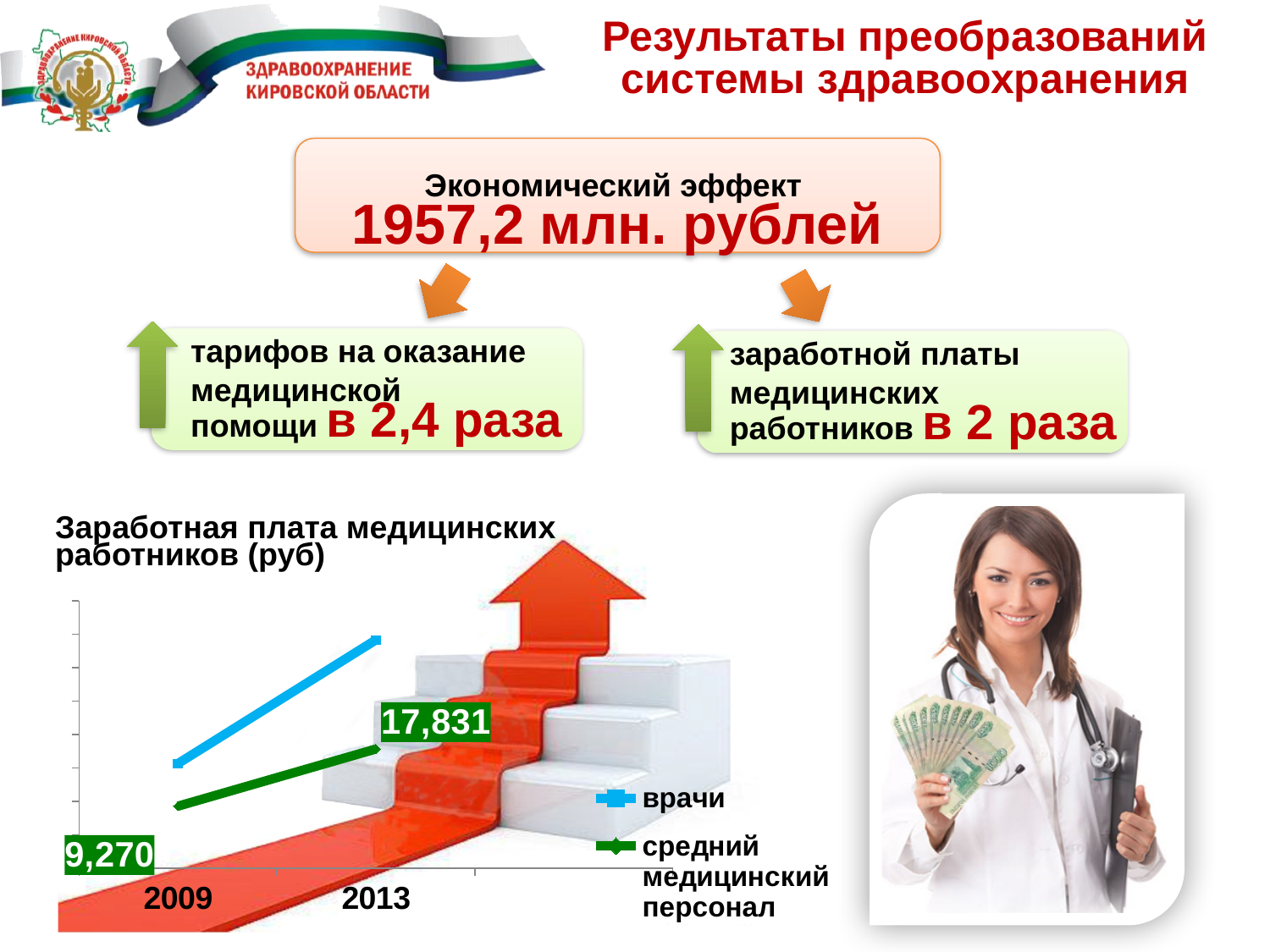
In 2009, which series has the higher value: врачи or средний медицинский персонал? врачи What is the value for средний медицинский персонал in 2013? 17,831 Which series has the lowest value on the chart? средний медицинский персонал Do the salary values rise or fall from 2009 to 2013? rise Which series has the highest value on the chart? врачи How many series does the chart legend list? 2 What kind of chart is shown on the slide? line chart Which series is drawn in blue on the chart? врачи How many years are labelled on the x axis of the chart? 2 In 2013, which series has the higher value: врачи or средний медицинский персонал? врачи What is the title of the chart on the slide? Заработная плата медицинских работников (руб) What is the lowest value printed as a data label on the chart? 9,270